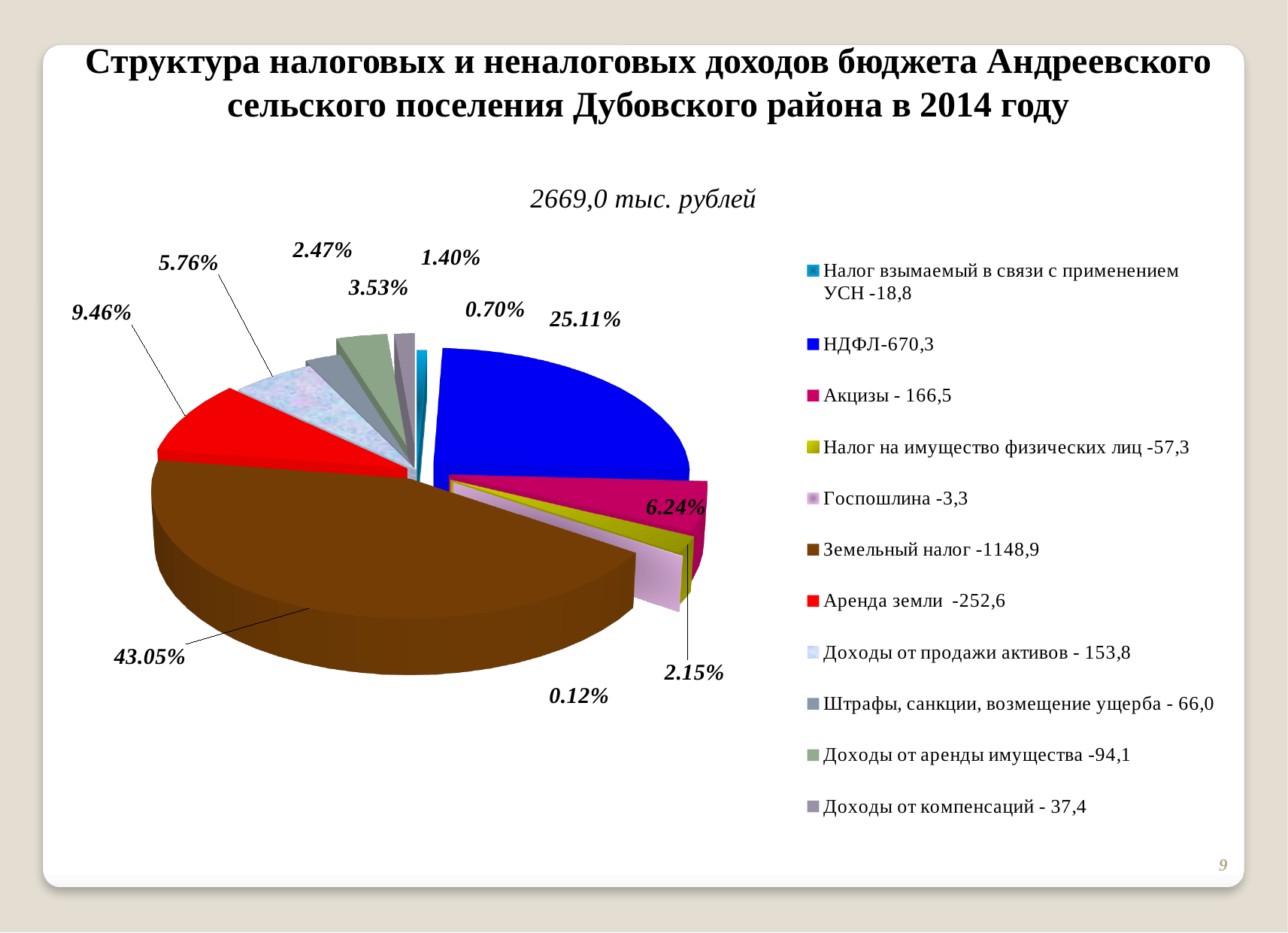
What kind of chart is shown on the slide? Pie chart What is the value shown in the legend for Доходы от продажи активов? 153,8 What share of the pie does Земельный налог take? 43.05% How many categories does the legend of the pie chart list? 11 What total amount is shown above the pie chart? 2669,0 тыс. рублей What is the value shown in the legend for НДФЛ? 670,3 What share of the pie does НДФЛ take? 25.11% Which category has the largest value in the pie chart? Земельный налог Which is larger: the value for Акцизы or the value for Доходы от аренды имущества? Акцизы Which category has the smallest value in the pie chart? Госпошлина What is the value shown in the legend for Аренда земли? 252,6 What is the difference between the values for НДФЛ and Аренда земли? 417,7